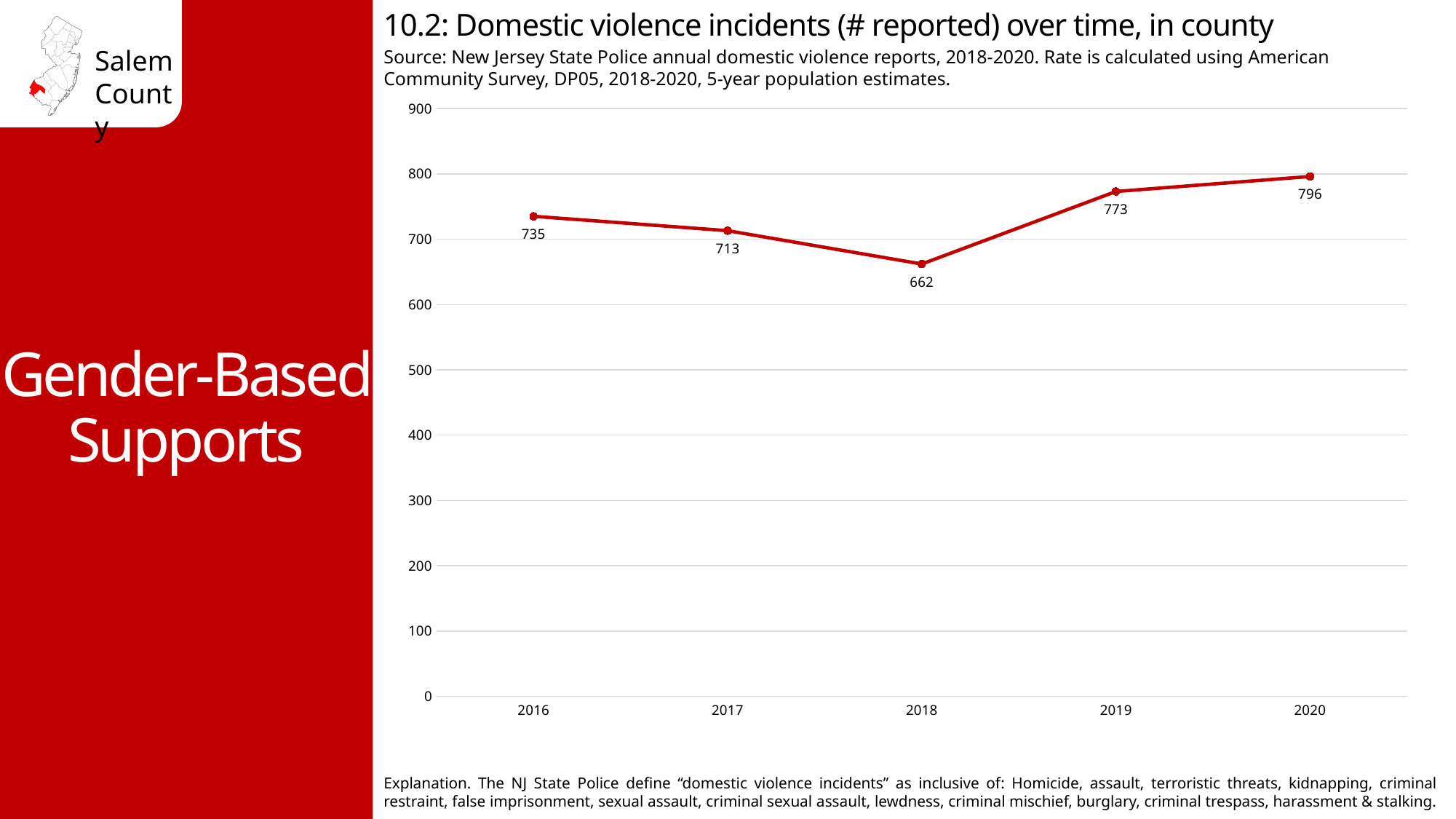
What was the number of reported domestic violence incidents in 2016? 735 Is the value for 2019 greater or less than 700? greater What kind of chart is shown on the slide? Line chart What was the number of reported domestic violence incidents in 2020? 796 Which year had the lowest number of reported domestic violence incidents? 2018 What was the number of reported domestic violence incidents in 2018? 662 Which year had more reported incidents, 2017 or 2019? 2019 How many years are plotted on the chart? 5 What is the difference between the number of incidents in 2020 and in 2018? 134 Which year had the highest number of reported domestic violence incidents? 2020 Did the number of reported incidents rise or fall from 2018 to 2020? Rise What is the difference between the number of incidents in 2016 and in 2017? 22